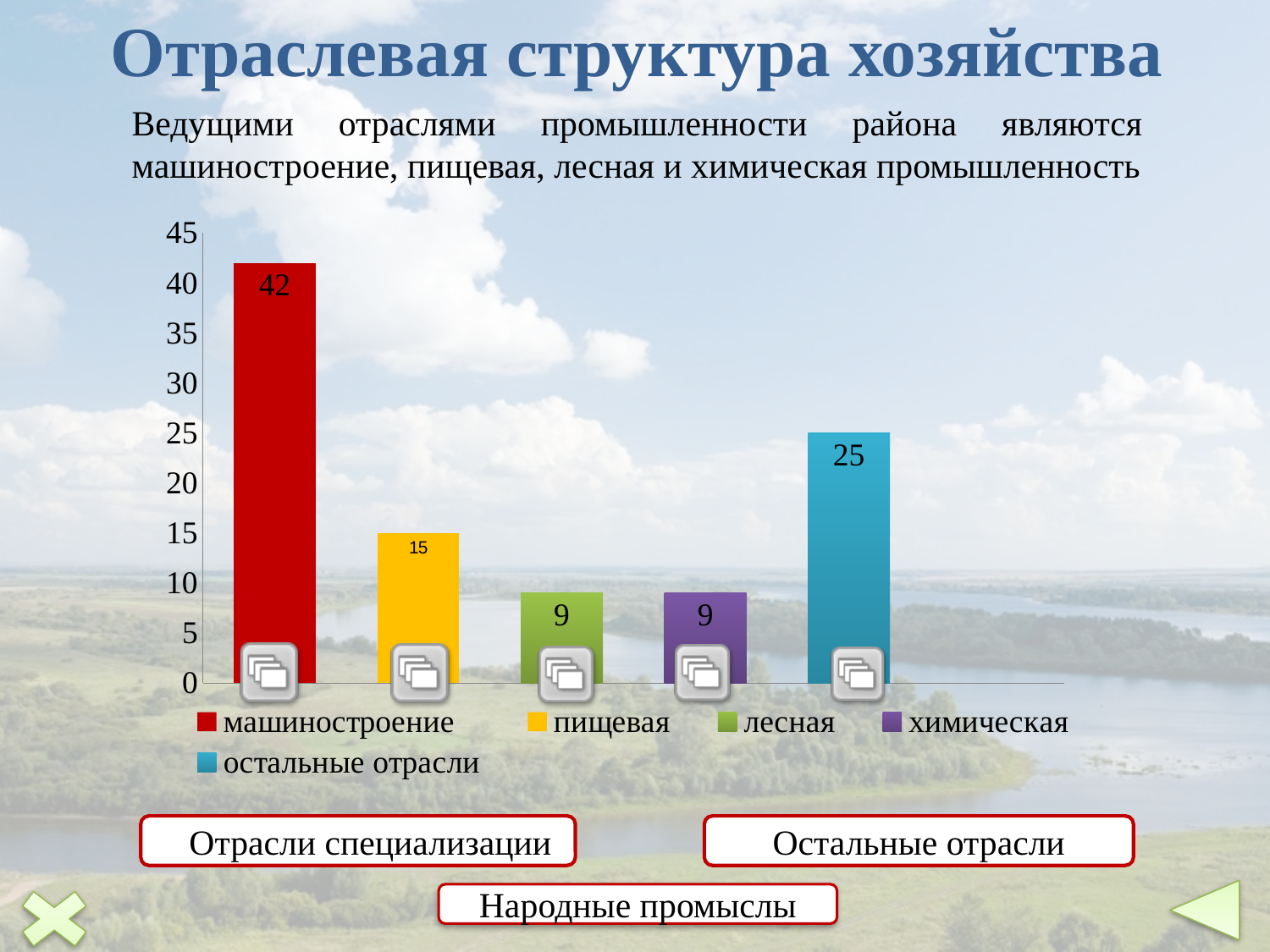
Which is larger, the value for пищевая or the value for остальные отрасли? остальные отрасли How many entries does the legend list? 5 What value is shown for пищевая? 15 What value is shown for машиностроение? 42 What is the difference between the values for пищевая and химическая? 6 How many bars are plotted in the chart? 5 What is the difference between the values for машиностроение and остальные отрасли? 17 What value is shown for лесная? 9 Which industry has the highest value in the chart? машиностроение What value is shown for остальные отрасли? 25 What type of chart is shown on the slide? bar chart Is the value for машиностроение greater or less than 40? greater